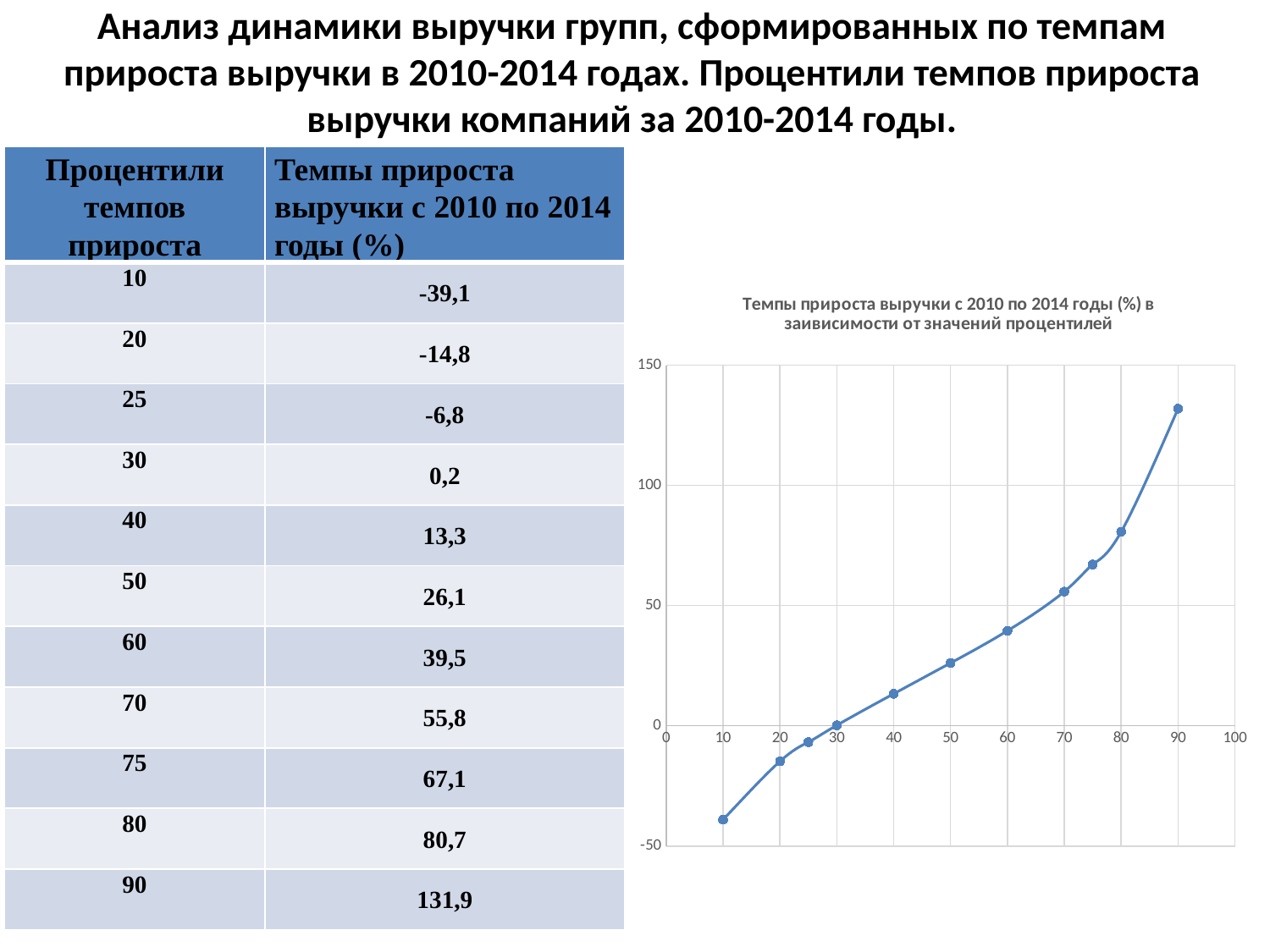
At which percentile is the revenue growth rate lowest? 10 What is the difference between the revenue growth rate at the 80th percentile and at the 60th percentile? 41,2 Do the plotted values rise or fall as the percentile increases along the x axis? rise Is the plotted value at the 20th percentile greater or less than 0? less At which percentile is the revenue growth rate highest? 90 Is the plotted value at the 90th percentile greater or less than 100? greater What kind of chart is shown on the right of the slide? line chart What is the revenue growth rate (%) at the 50th percentile? 26,1 How many data points are plotted on the chart? 11 What is the revenue growth rate (%) at the 10th percentile? -39,1 Which is larger, the value at the 70th percentile or the value at the 40th percentile? 70th percentile What is the revenue growth rate (%) at the 90th percentile? 131,9